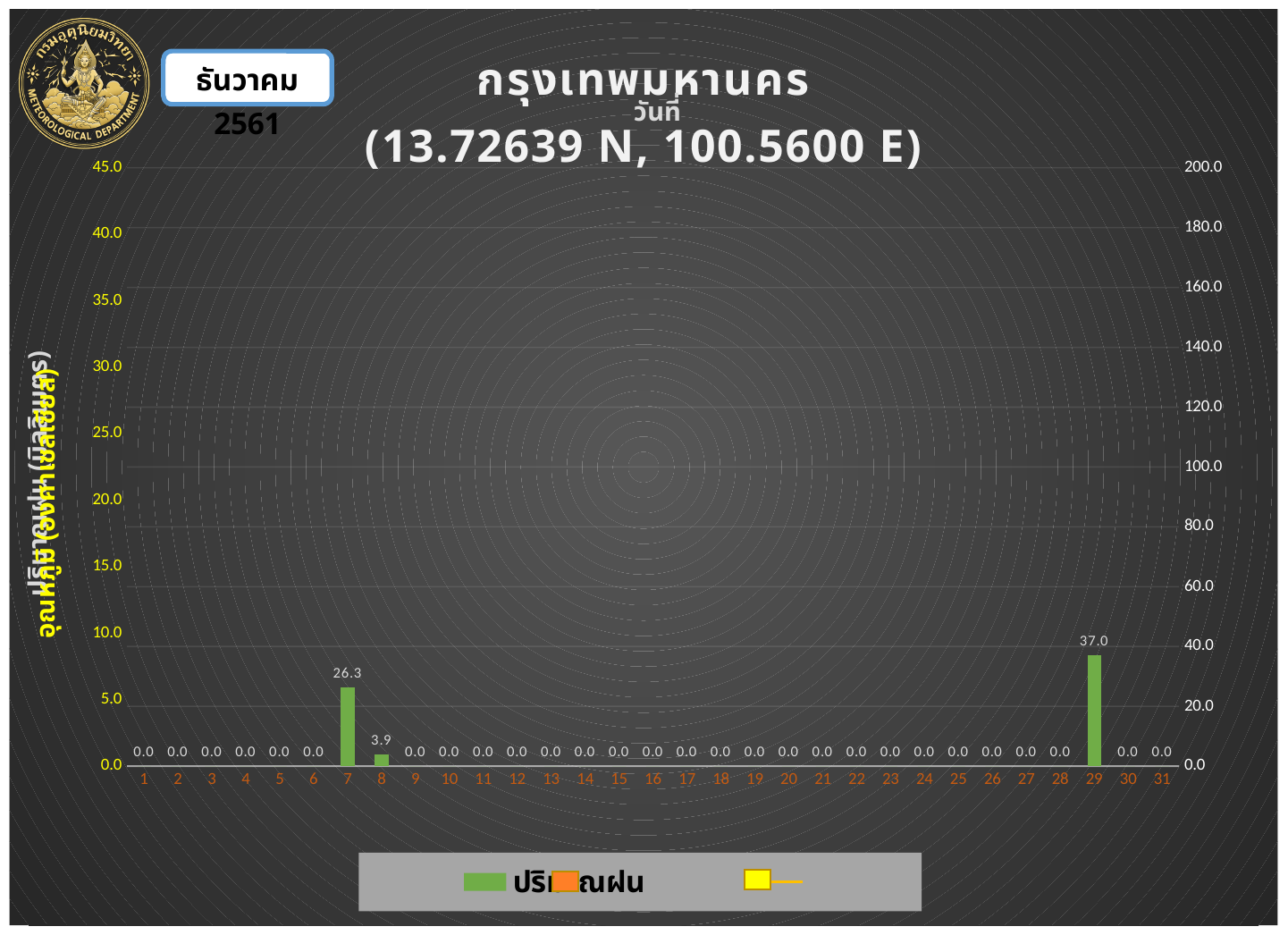
What is the difference between the rainfall values for day 7 and day 8? 22.4 Which day has the highest rainfall value? 29 What kind of chart is shown on the slide? bar chart What is the difference between the rainfall values for day 29 and day 7? 10.7 Is the value for day 29 greater or less than 20.0 on the right-hand axis? greater What colour are the rainfall bars in the chart? green What is the rainfall value shown for day 7? 26.3 How many days are shown on the x axis? 31 Which day has the larger rainfall value, day 7 or day 8? day 7 What is the rainfall value shown for day 8? 3.9 What is the rainfall value shown for day 15? 0.0 What is the rainfall value shown for day 29? 37.0